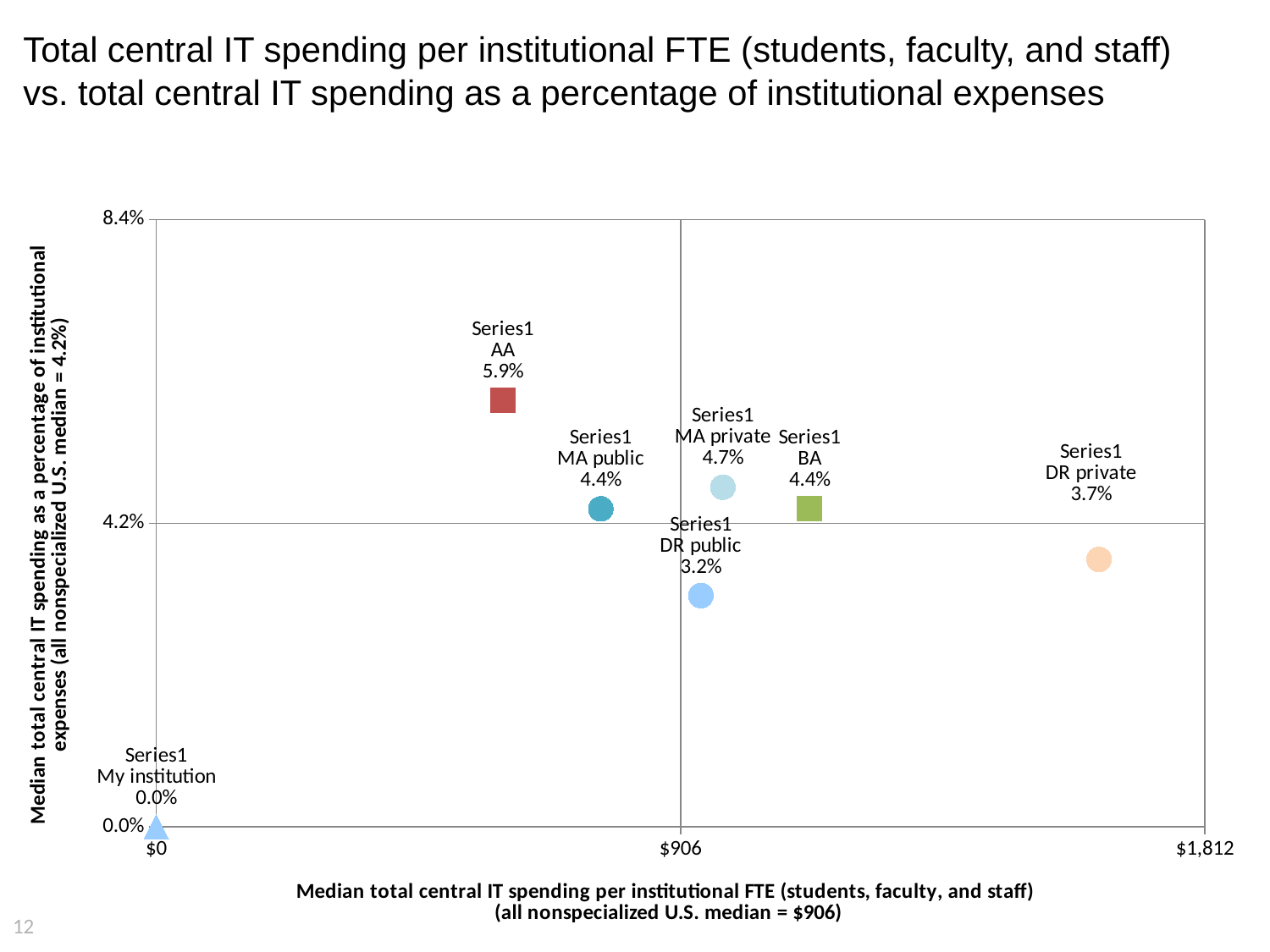
How many data points are plotted on the chart? 7 Is the median total central IT spending per institutional FTE for AA greater or less than $906? less What kind of chart is shown on the slide? Scatter chart What percentage value is shown for DR public institutions? 3.2% What percentage value is shown for DR private institutions? 3.7% What is the difference in percentage points between the AA value and the DR public value? 2.7 percentage points Which labeled point has the lowest percentage value on the chart? My institution What is the median total central IT spending as a percentage of institutional expenses for AA institutions? 5.9% Which has a higher percentage value, MA private or BA? MA private Is the median total central IT spending per institutional FTE for DR private greater or less than $906? greater Which institution type has the highest central IT spending as a percentage of institutional expenses? AA According to the x-axis label, what is the all nonspecialized U.S. median for total central IT spending per institutional FTE? $906